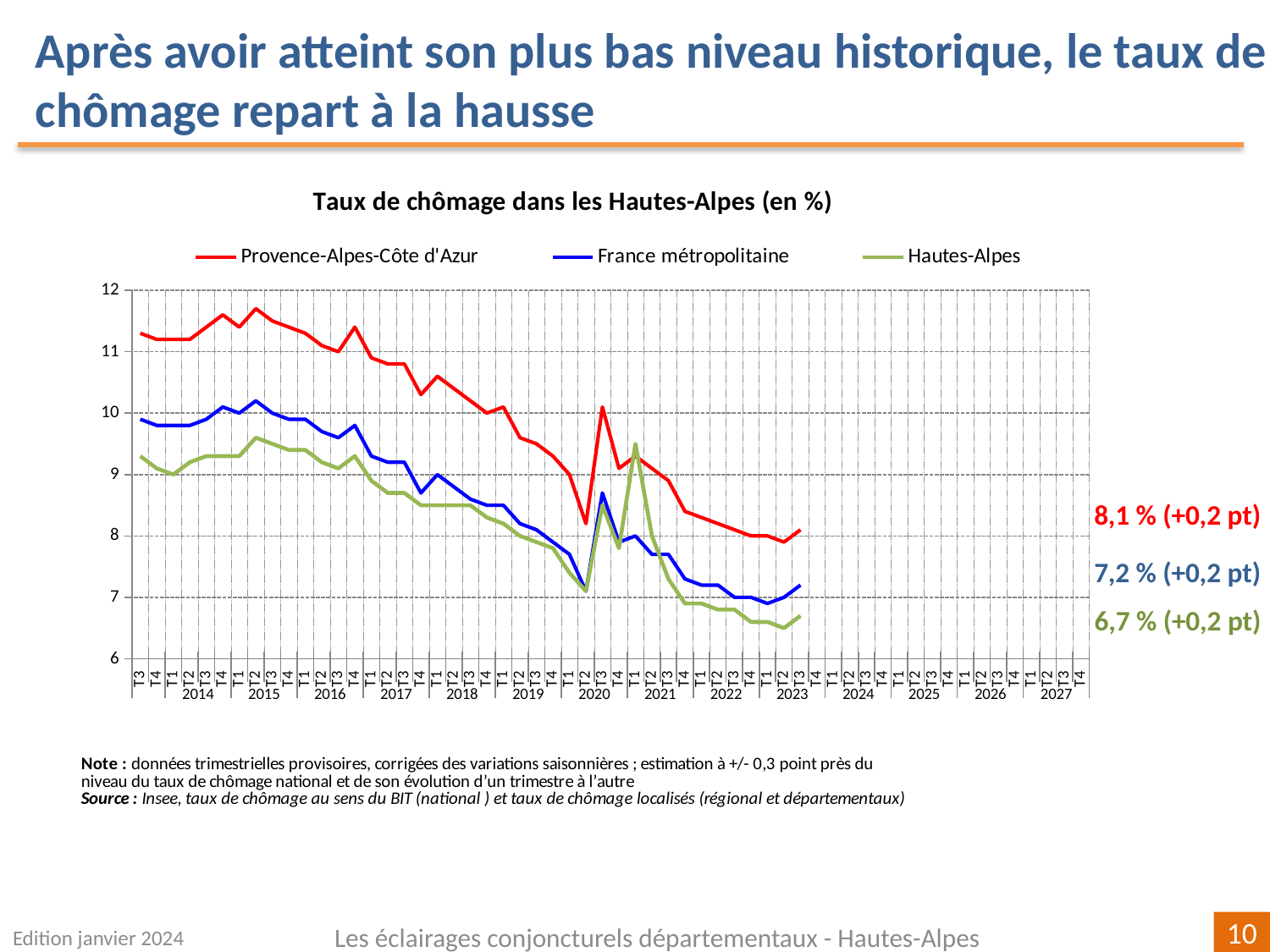
What is the title of the chart? Taux de chômage dans les Hautes-Alpes (en %) Is the Provence-Alpes-Côte d'Azur value in T2 2015 greater or less than 11? greater What kind of chart is shown on the slide? Line chart What is the latest unemployment rate shown for Provence-Alpes-Côte d'Azur? 8,1 % By how many points did the Hautes-Alpes rate change in the latest quarter, according to the label? +0,2 pt What is the latest unemployment rate shown for Hautes-Alpes? 6,7 % Overall, do the unemployment rates rise or fall from 2014 to 2023? fall Which series has the lowest value at the end of the chart? Hautes-Alpes What is the latest unemployment rate shown for France métropolitaine? 7,2 % What is the difference between the latest Provence-Alpes-Côte d'Azur rate and the latest Hautes-Alpes rate? 1,4 Which series has the highest value at the end of the chart? Provence-Alpes-Côte d'Azur How many series does the legend list? 3